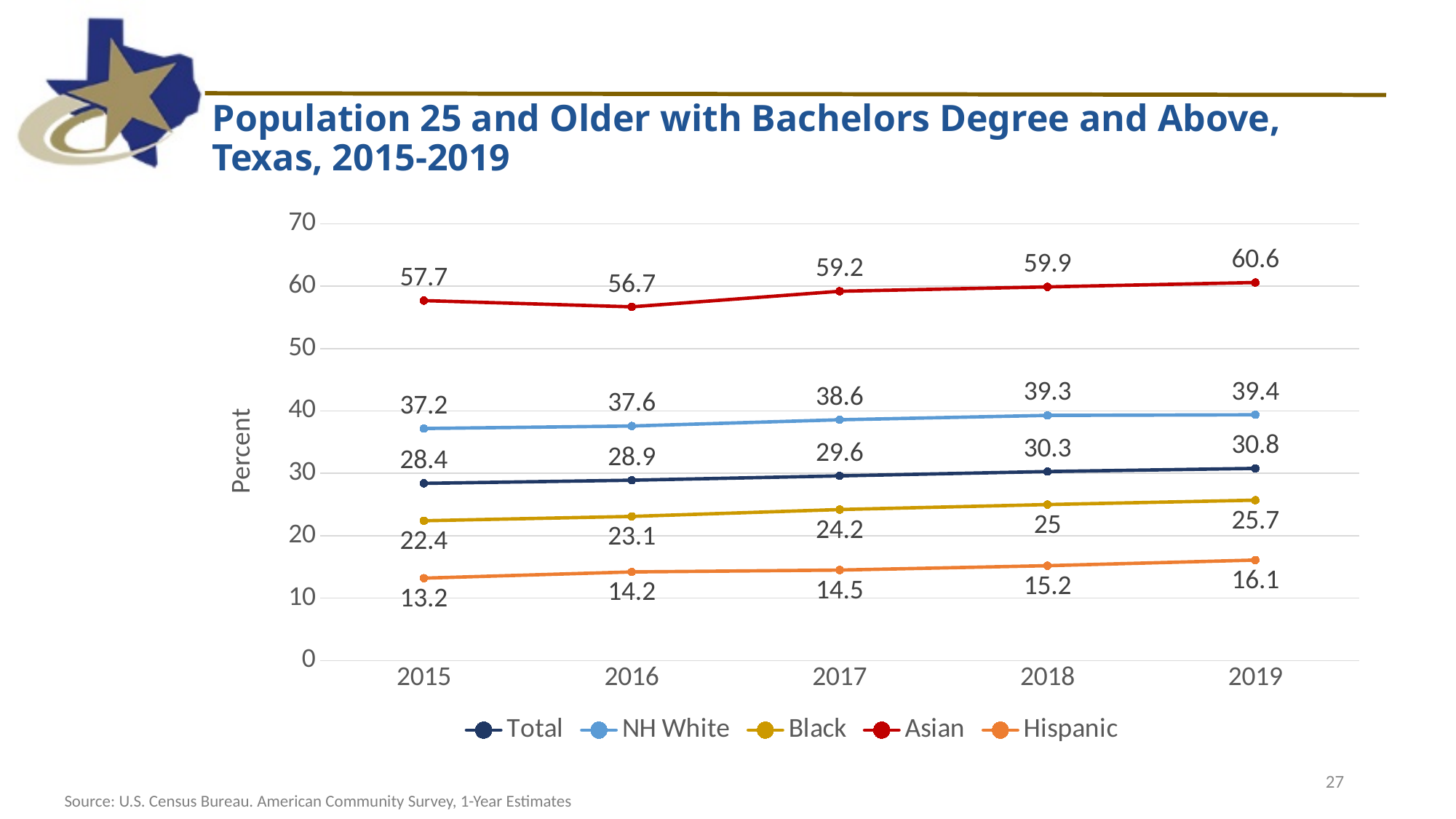
What is the difference between the NH White and Total values in 2019? 8.6 How many years are shown on the x axis? 5 What is the value for Black in 2018? 25 What is the value for Asian in 2019? 60.6 Does the NH White series rise or fall from 2015 to 2019? Rise Which is larger, the Asian value in 2015 or the Asian value in 2016? 2015 Which series has the lowest value in 2015? Hispanic Which series has the highest value in 2019? Asian What is the value for Total in 2017? 29.6 How many series does the legend list? 5 What is the value for Hispanic in 2015? 13.2 What kind of chart is shown on the slide? Line chart